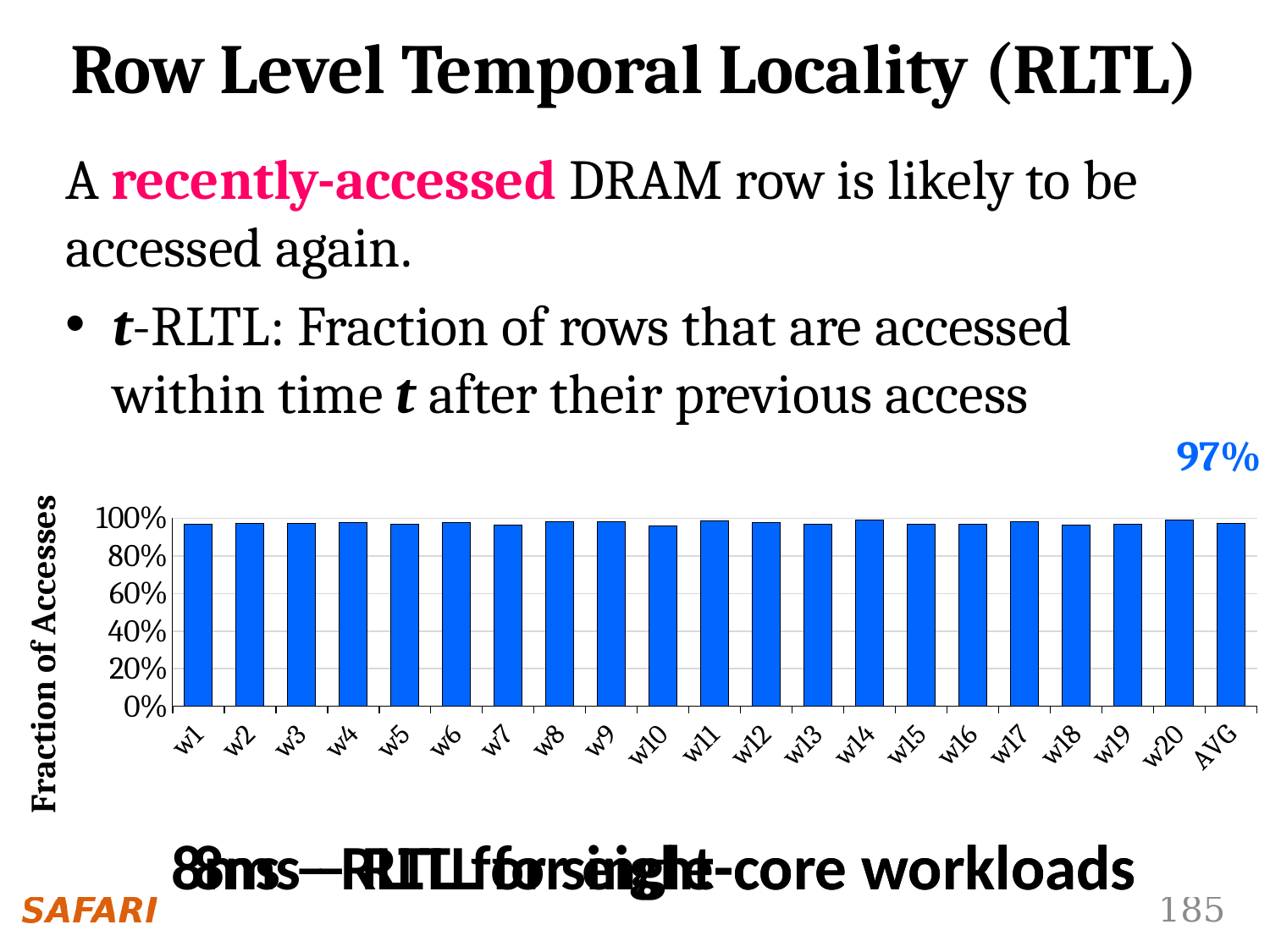
Is the value for AVG greater or less than 40%? greater What is the label of the y axis of the chart? Fraction of Accesses What value is annotated for the AVG bar on the chart? 97% Is the value for w1 greater or less than 80%? greater What is the label of the last category on the x axis? AVG How many data series are plotted in the chart? 1 Is the value for w20 greater or less than 20%? greater What kind of chart is shown on the slide? bar chart Do the bar values rise, fall, or stay roughly flat from w1 to w20? roughly flat What is the highest tick value shown on the y axis? 100% How many categories are shown along the x axis of the chart? 21